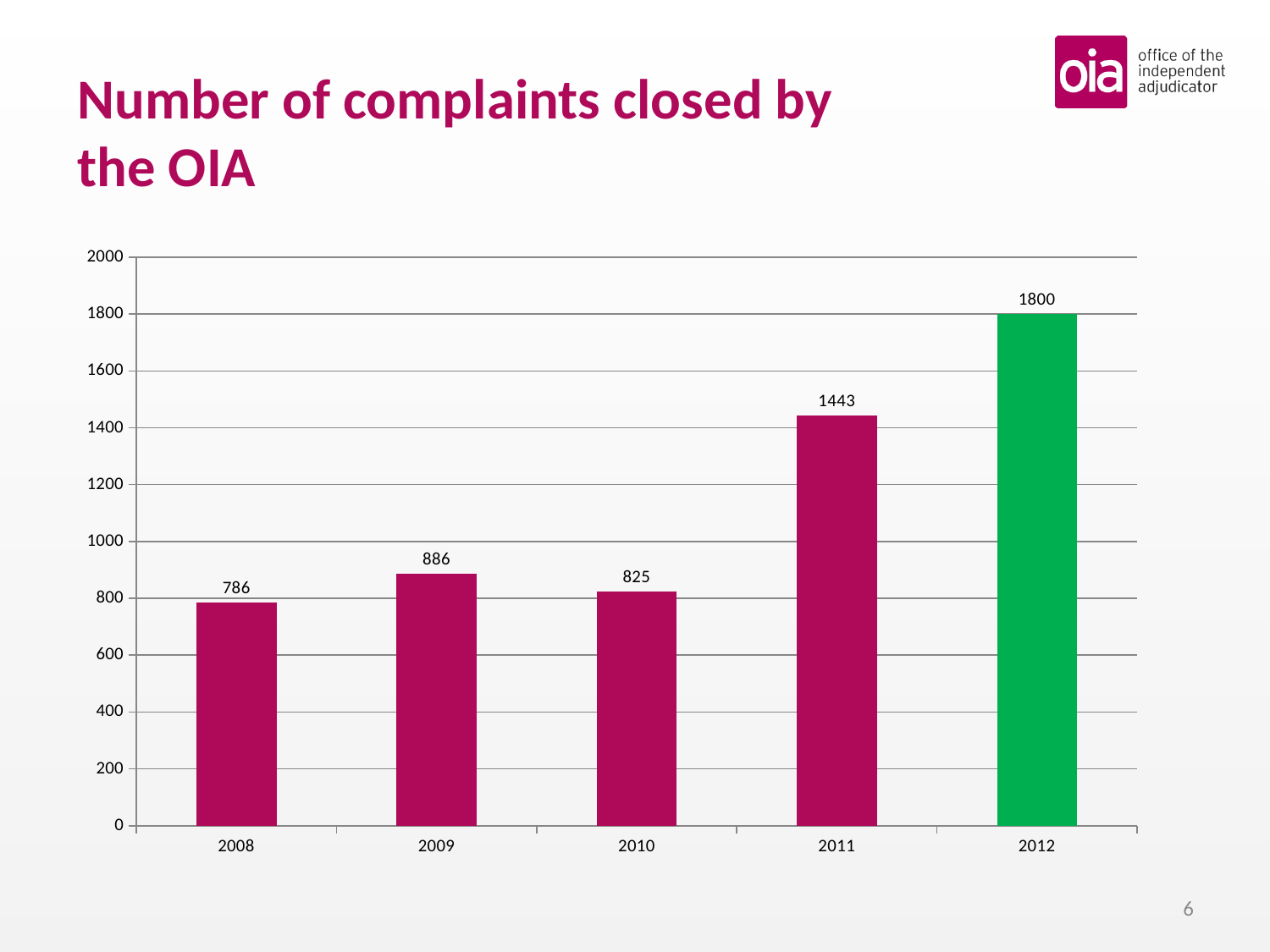
What is the value shown for 2010? 825 What is the difference between the values for 2012 and 2011? 357 Which year has the highest number of complaints closed? 2012 Is the value for 2011 greater or less than 1400? greater Which year has the larger value, 2009 or 2010? 2009 What kind of chart is shown on the slide? Bar chart What is the value shown for 2008? 786 How many complaints were closed by the OIA in 2011? 1443 Which bar is coloured green rather than magenta? 2012 Which year has the lowest number of complaints closed? 2008 What is the difference between the values for 2009 and 2010? 61 How many years are shown on the x axis? 5